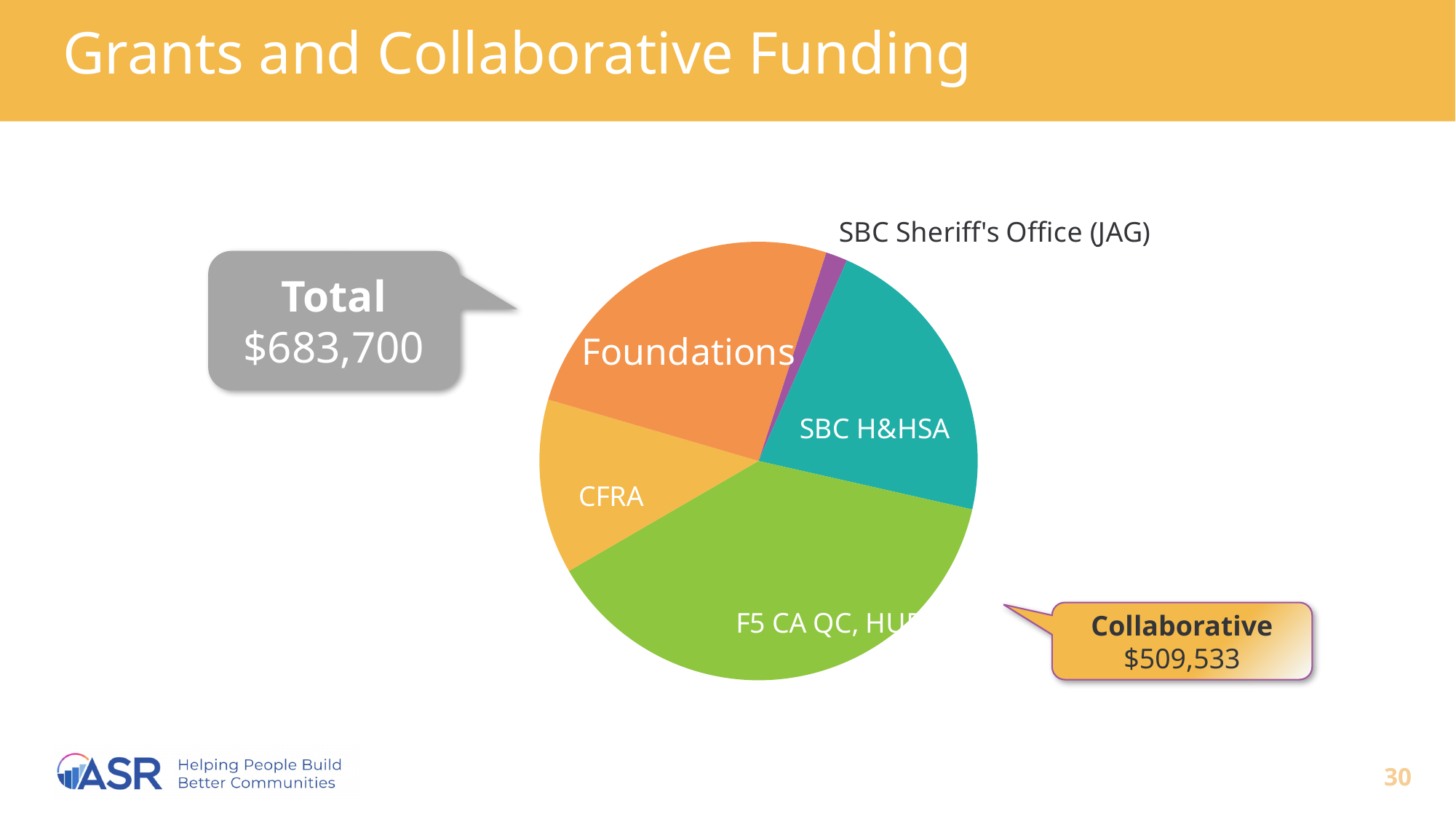
Which slice of the pie chart is the smallest? SBC Sheriff's Office (JAG) What total amount is shown in the grey callout next to the pie chart? $683,700 Which slice is larger, Foundations or CFRA? Foundations What amount is shown in the Collaborative callout? $509,533 Which slice is smaller, CFRA or SBC Sheriff's Office (JAG)? SBC Sheriff's Office (JAG) Which slice is larger, SBC H&HSA or CFRA? SBC H&HSA How many slices does the pie chart have? 5 What kind of chart is shown on the slide? Pie chart